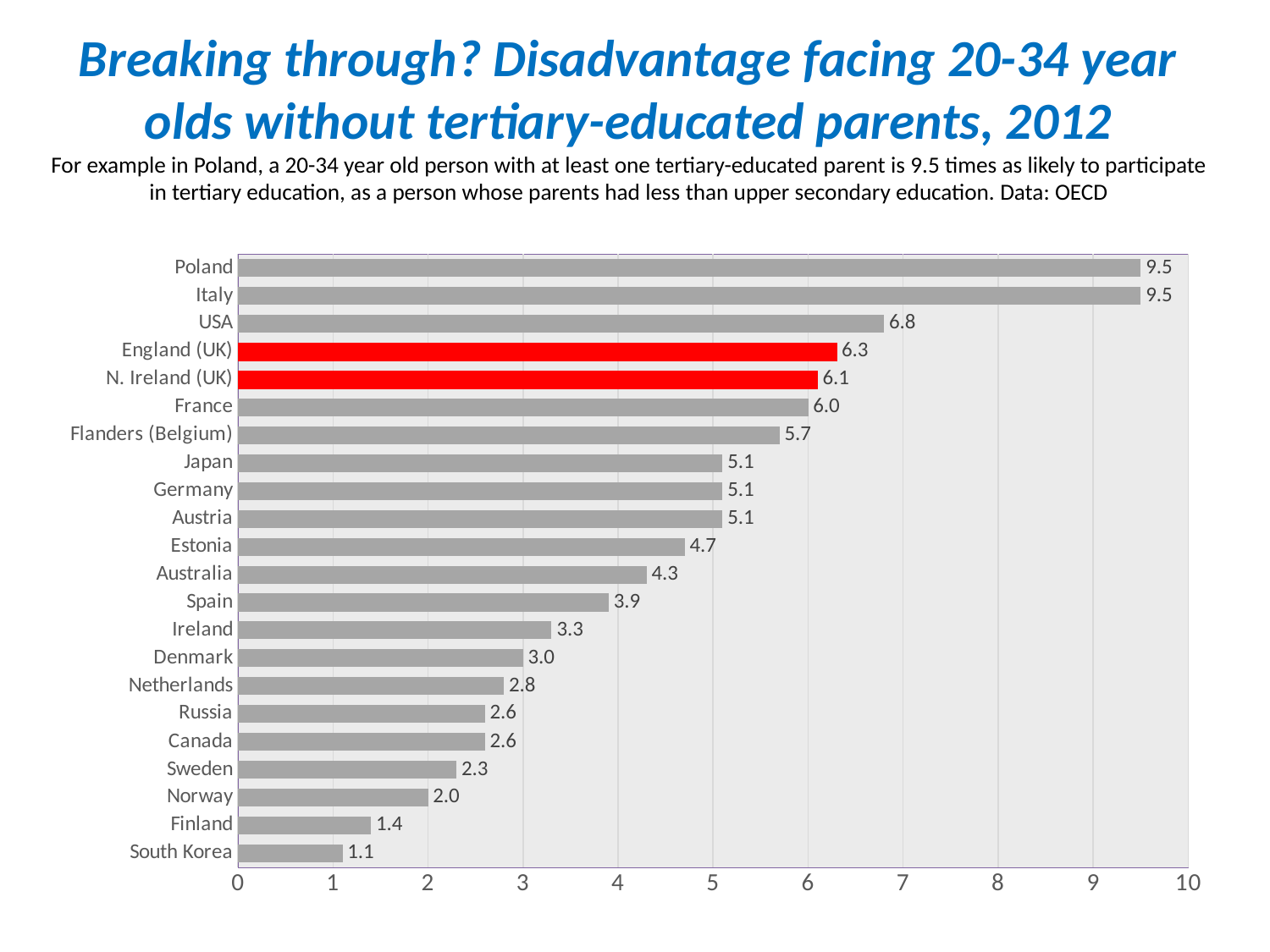
Which is larger, the value for Denmark or the value for Spain? Spain What is the value for Finland? 1.4 What is the difference between the values for USA and N. Ireland (UK)? 0.7 What is the value for Flanders (Belgium)? 5.7 What kind of chart is shown on the slide? Bar chart Which country has the lowest value? South Korea Which is larger, the value for Estonia or the value for Australia? Estonia How many countries or regions are shown in the chart? 22 What is the value for England (UK)? 6.3 Which two bars are highlighted in red? England (UK) and N. Ireland (UK) What is the difference between the values for Poland and South Korea? 8.4 What is the maximum value shown on the horizontal axis? 10